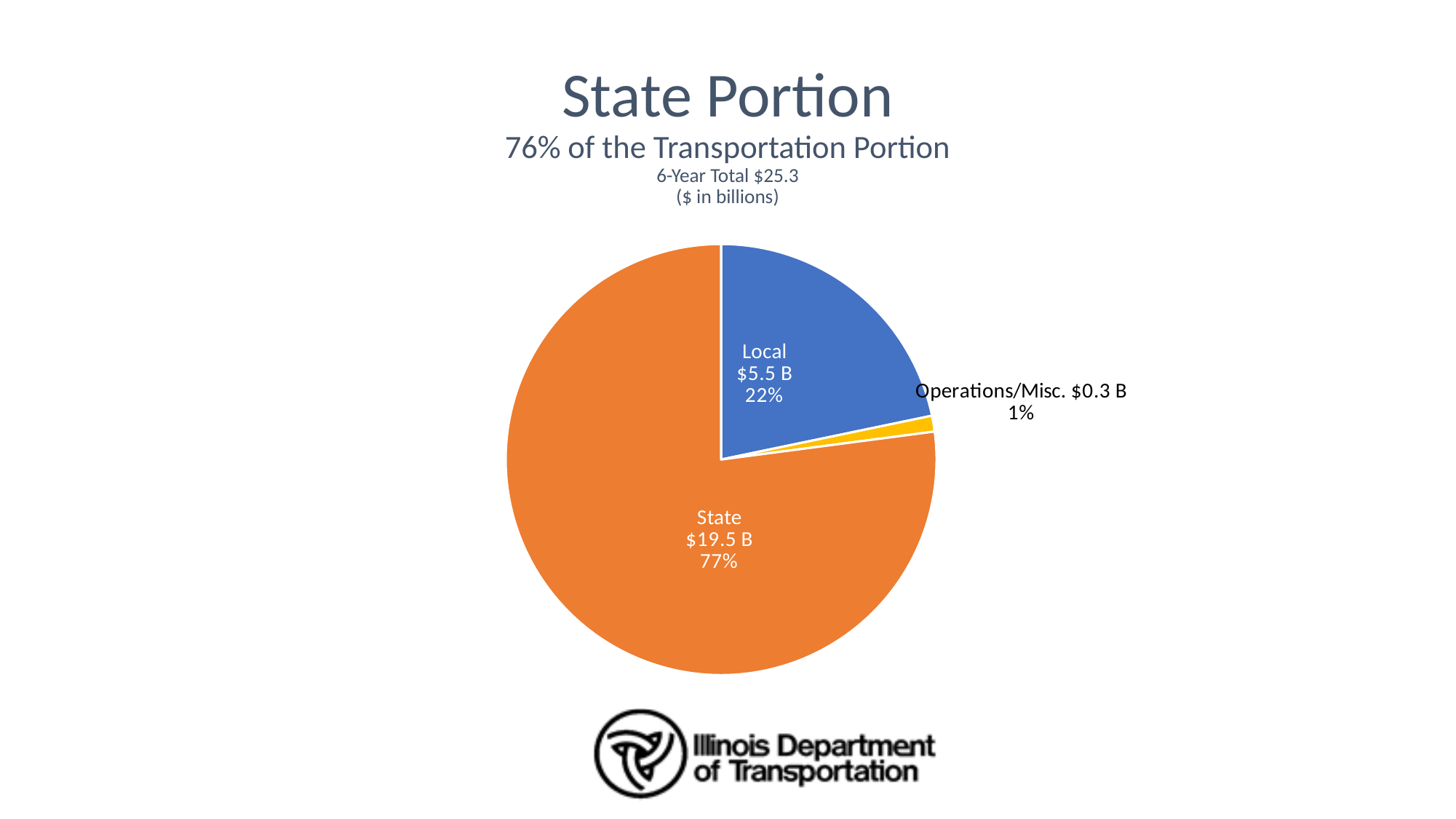
What is the value for the Local slice? $5.5 B What is the difference between the State value and the Local value? $14.0 B What kind of chart is shown on the slide? pie chart What share of the pie does the Operations/Misc. slice represent? 1% What is the value for the State slice? $19.5 B What is the title of the slide? State Portion What is the value for the Operations/Misc. slice? $0.3 B Which slice is the smallest? Operations/Misc. How many slices does the pie chart have? 3 Which slice is the largest? State What share of the pie does the State slice represent? 77% What share of the pie does the Local slice represent? 22%